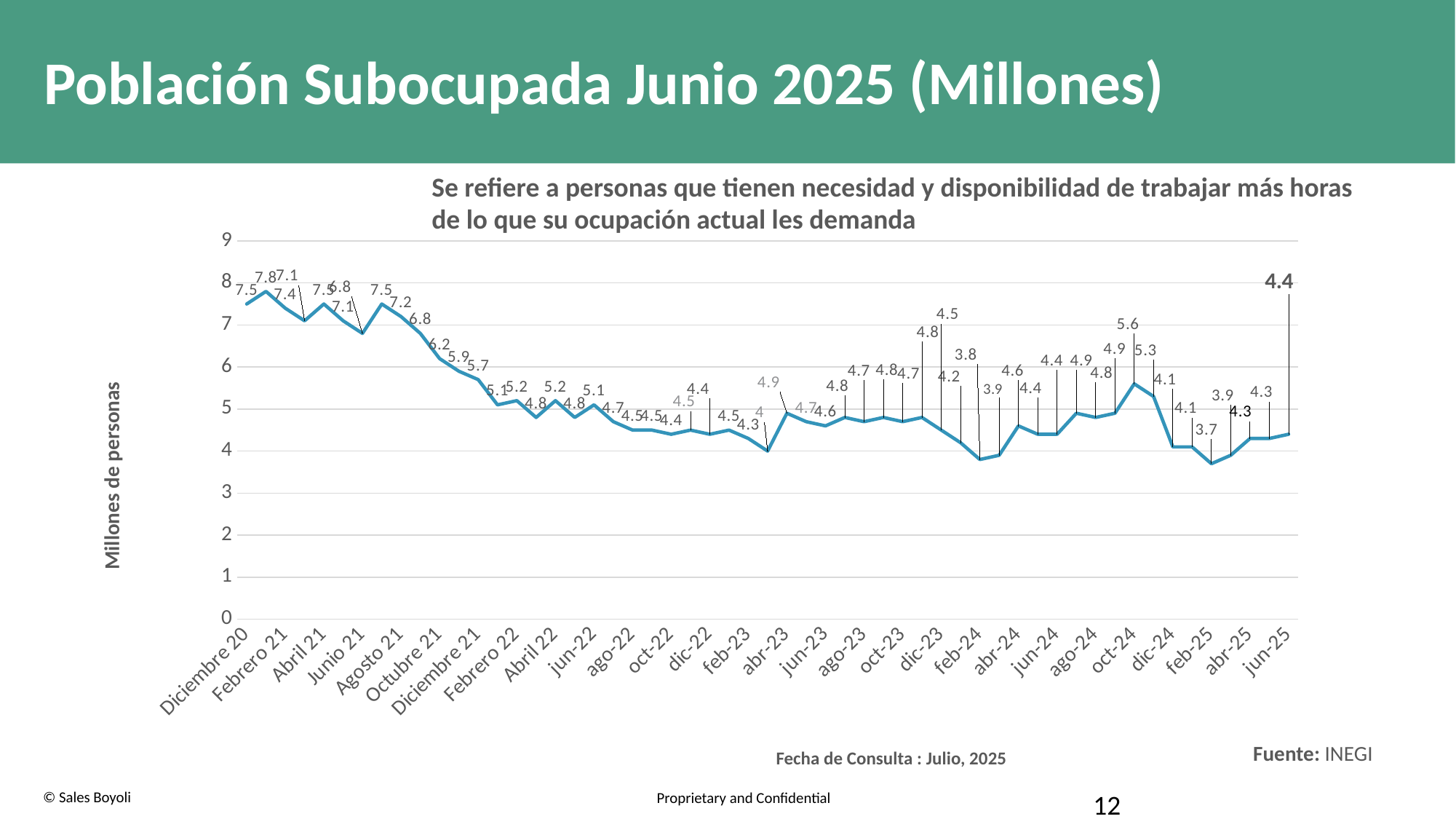
What kind of chart is shown on the slide? line chart Which is larger, the value for oct-24 or the value for jun-25? oct-24 What is the value for oct-24? 5.6 What is the lowest value plotted on the chart? 3.7 What is the value for Diciembre 20? 7.5 What is the difference between the value for Diciembre 20 and the value for jun-25? 3.1 What is the value for feb-25? 3.7 What is the label of the vertical axis? Millones de personas Is the value for Diciembre 20 greater or less than 7? greater What is the highest value plotted on the chart? 7.8 Overall, do the values rise or fall from Diciembre 20 to jun-25? fall What is the value for jun-25? 4.4